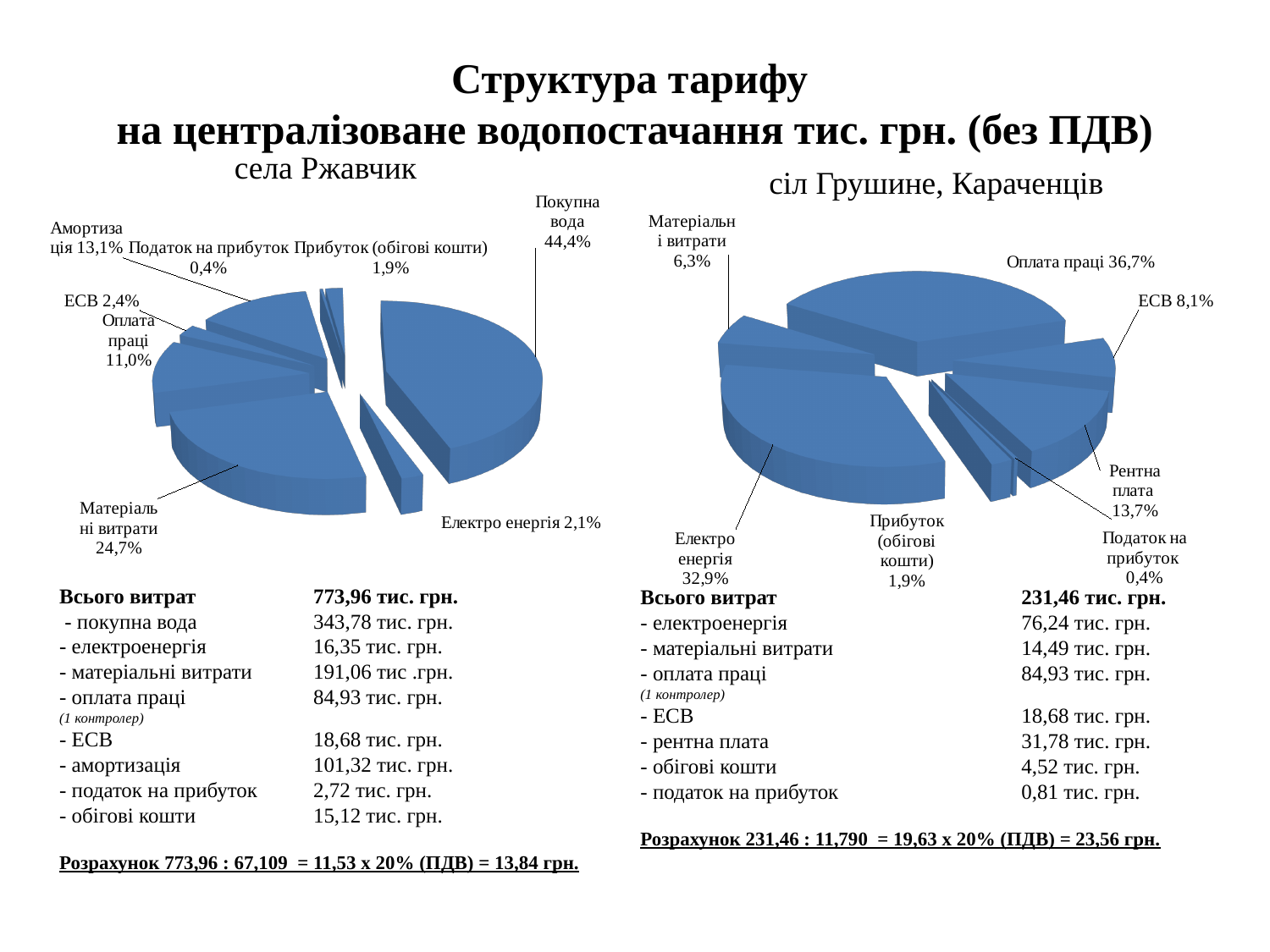
In the pie chart for села Ржавчик, what share does Матеріальні витрати have? 24,7% In the pie chart for села Ржавчик, what is the difference in percentage points between Амортизація and Оплата праці? 2,1 What type of chart is used for сіл Грушине, Караченців? Pie chart In the pie chart for села Ржавчик, how many slices are there? 8 In the pie chart for села Ржавчик, which category has the largest share? Покупна вода In the pie chart for сіл Грушине, Караченців, which category has the largest share? Оплата праці In the pie chart for сіл Грушине, Караченців, what share does Рентна плата have? 13,7% In the pie chart for сіл Грушине, Караченців, what share does Електро енергія have? 32,9% In the pie chart for сіл Грушине, Караченців, which is larger: ЕСВ or Матеріальні витрати? ЕСВ In the pie chart for села Ржавчик, which category has the smallest share? Податок на прибуток In the pie chart for сіл Грушине, Караченців, how many slices are there? 7 In the pie chart for села Ржавчик, what share does Покупна вода have? 44,4%